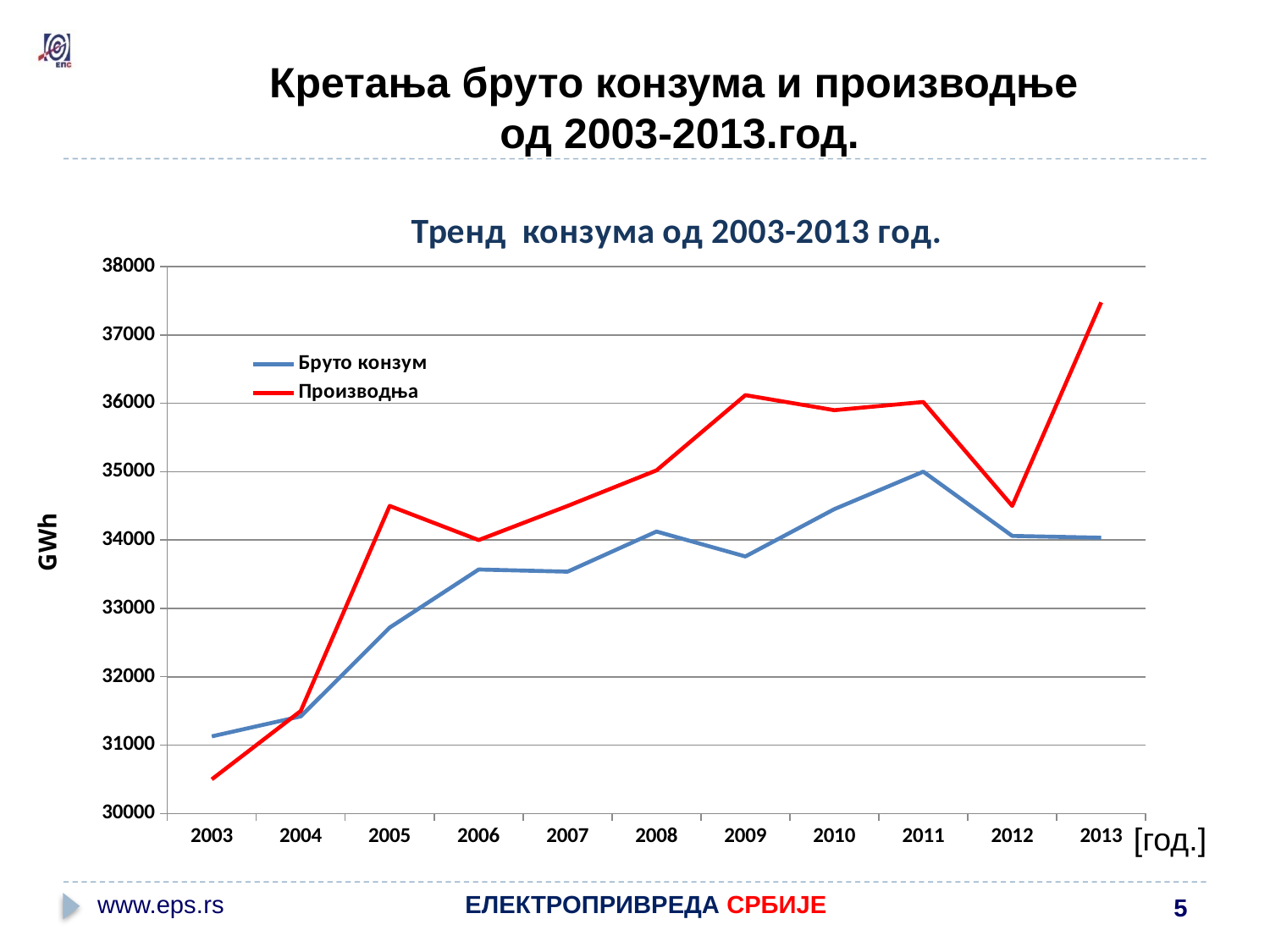
How many series does the legend list? 2 How many years are plotted along the x axis? 11 Is the value for Производња in 2013 greater or less than 37000? greater Is the value for Бруто конзум in 2009 greater or less than 34000? less In which year is Производња lowest? 2003 What is the title of the chart? Тренд конзума од 2003-2013 год. In which year is Производња highest? 2013 In which year is Бруто конзум highest? 2011 Which series has the higher value in 2003, Бруто конзум or Производња? Бруто конзум Does Производња rise or fall from 2011 to 2012? fall What unit is shown on the y axis label? GWh What kind of chart is shown on the slide? line chart